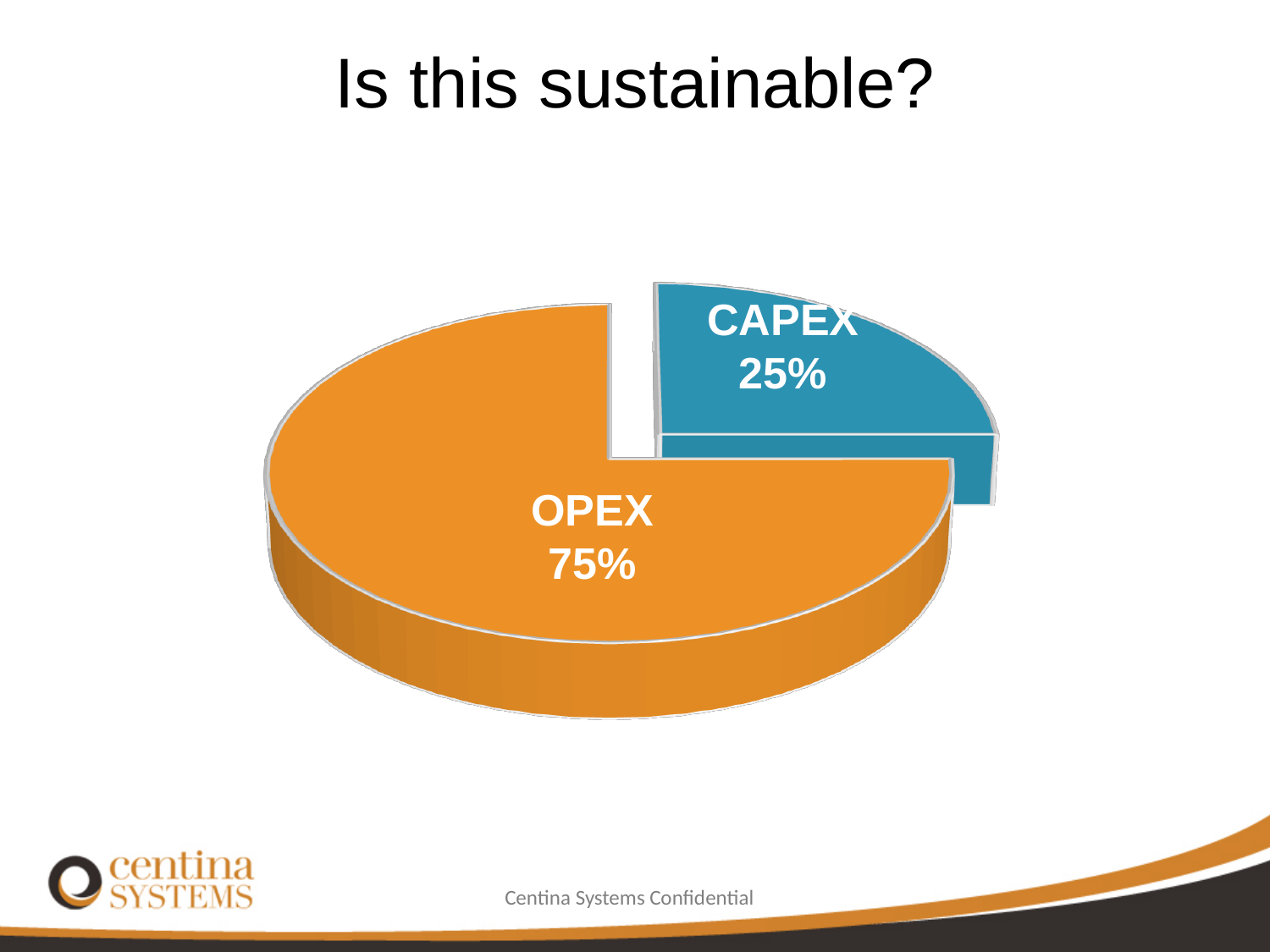
Which slice of the pie is the smallest? CAPEX What is the title of the slide containing the chart? Is this sustainable? Which is larger, the OPEX slice or the CAPEX slice? OPEX What is the difference in percentage points between the OPEX and CAPEX slices? 50 What kind of chart is shown on the slide? Pie chart What share of the pie does CAPEX represent? 25% How many slices does the pie chart have? 2 What share of the pie does OPEX represent? 75% What colour is the CAPEX slice? Blue Which slice of the pie is the largest? OPEX